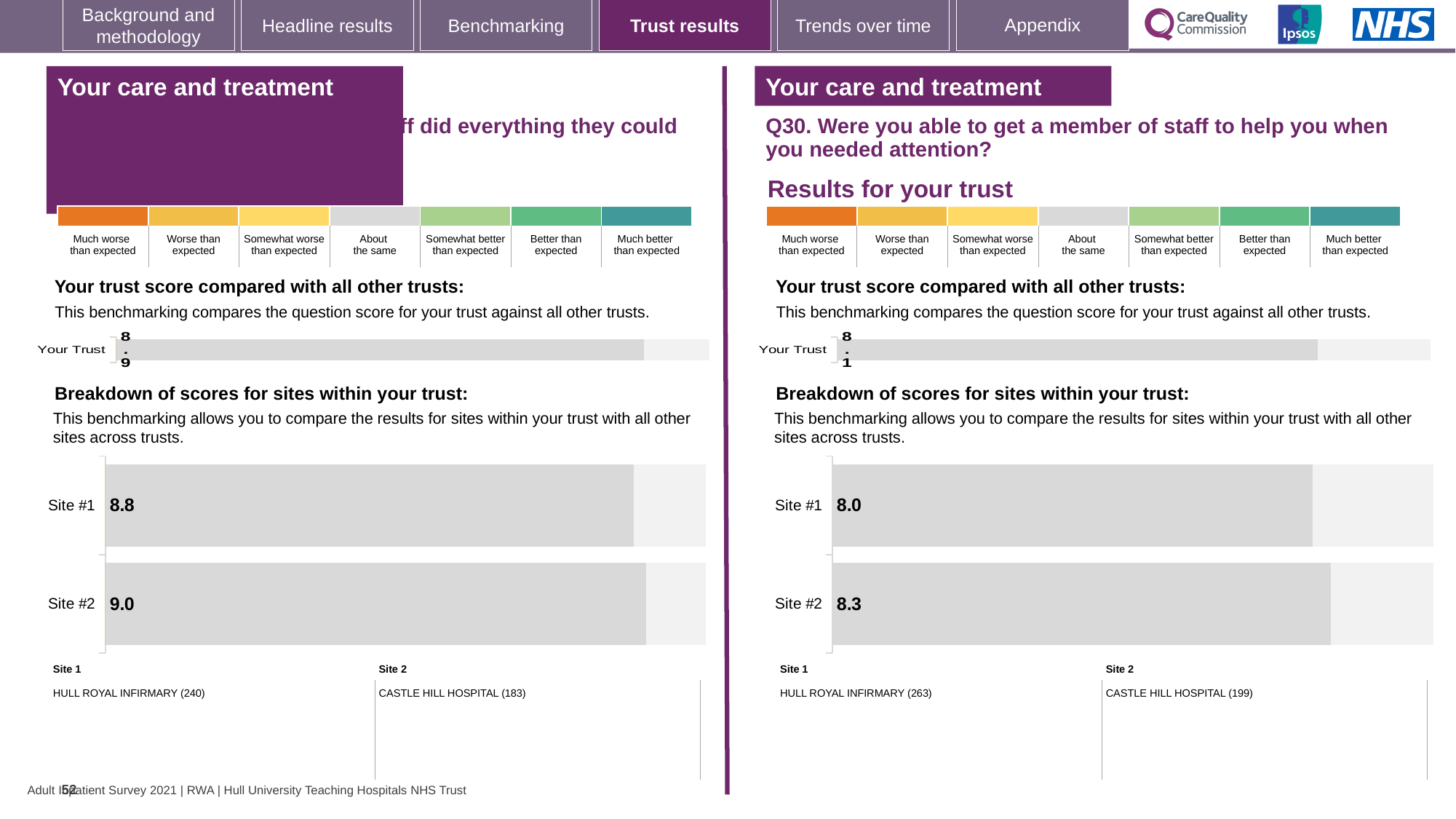
On the right-hand chart for Q30, which site has the higher score? Site #2 On the left-hand 'Your trust score compared with all other trusts' chart, what is the score for Your Trust? 8.9 How many sites are shown in the right-hand site breakdown chart for Q30? 2 On the left-hand site breakdown chart, what is the score for Site #2? 9.0 On the right-hand chart for Q30, what is the score for Site #1? 8.0 On the left-hand site breakdown chart, what is the score for Site #1? 8.8 On the right-hand chart for Q30, what is the difference between the Site #2 and Site #1 scores? 0.3 On the right-hand chart for Q30, what is the score for Site #2? 8.3 What type of chart is used for the site breakdown on the right-hand side for Q30? Bar chart On the right-hand 'Your trust score compared with all other trusts' chart for Q30, what is the score for Your Trust? 8.1 On the left-hand site breakdown chart, which site has the lower score? Site #1 On the left-hand site breakdown chart, what is the difference between the Site #2 and Site #1 scores? 0.2